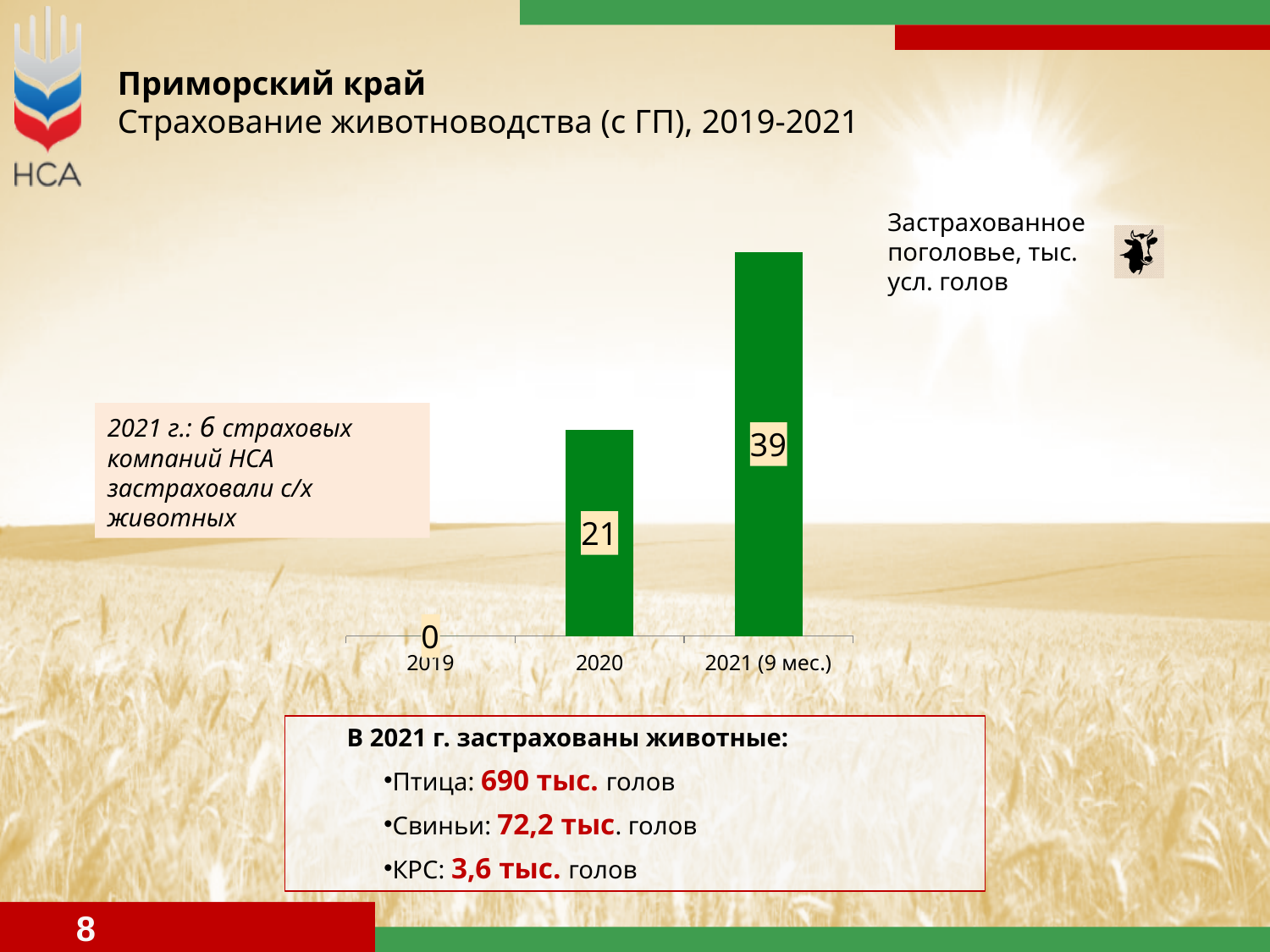
What is the insured livestock value for 2021 (9 мес.)? 39 Which year has the lowest insured livestock value? 2019 How many categories are shown on the x axis of the chart? 3 Do the values rise or fall from 2019 to 2021 (9 мес.)? rise Which year has the highest insured livestock value? 2021 (9 мес.) In what units are the chart values expressed, according to the label next to the chart? тыс. усл. голов What is the difference between the values for 2020 and 2019? 21 What kind of chart is shown on the slide? bar chart What is the insured livestock value for 2019? 0 What is the insured livestock value for 2020? 21 What is the difference between the values for 2021 (9 мес.) and 2020? 18 Which is larger, the value for 2020 or the value for 2021 (9 мес.)? 2021 (9 мес.)